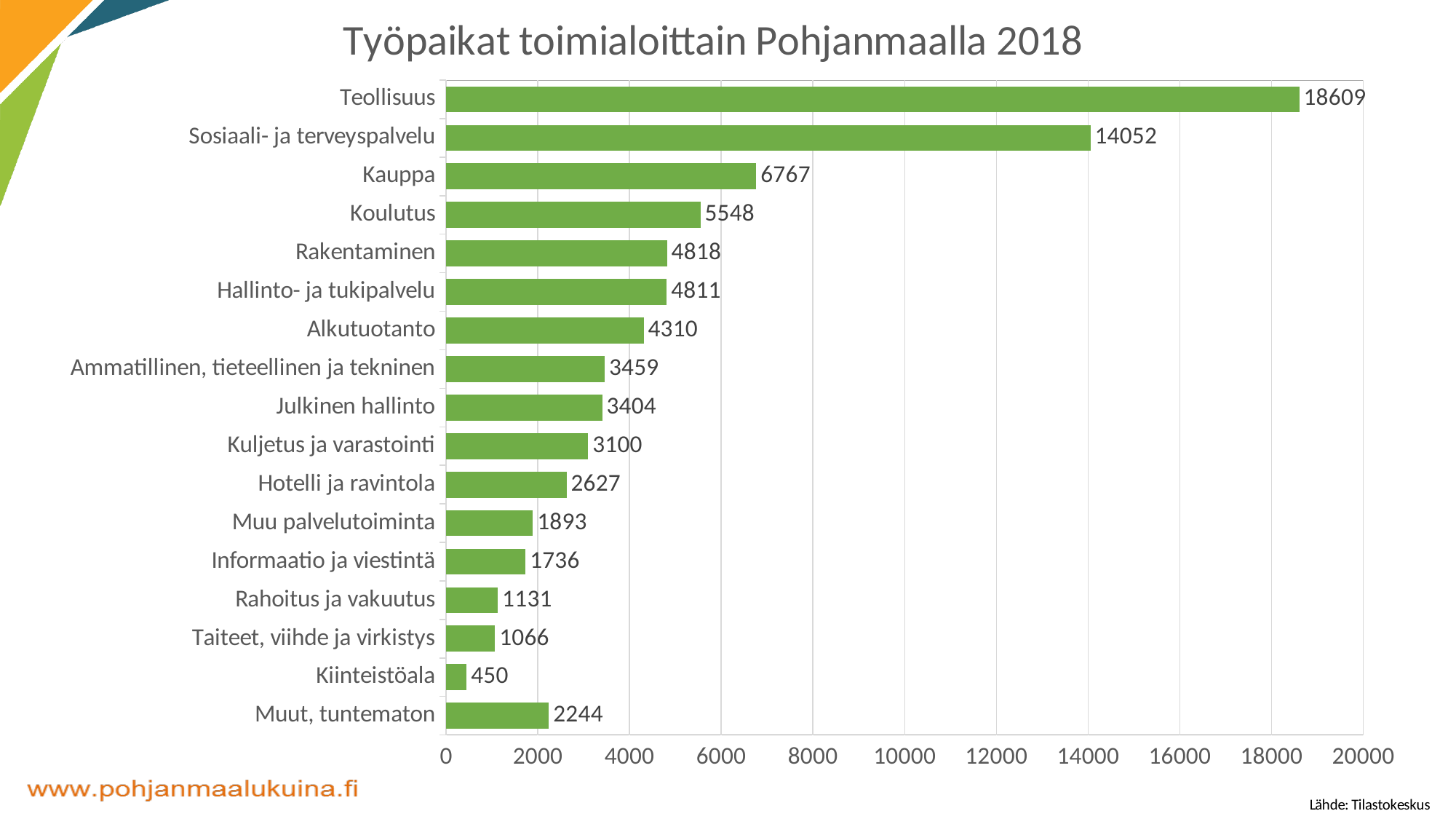
What is the difference between the values for Kauppa and Koulutus? 1219 What is the value for Muut, tuntematon? 2244 Is the value for Alkutuotanto greater or less than 4000? greater What is the title of the chart? Työpaikat toimialoittain Pohjanmaalla 2018 Which category has the lowest value? Kiinteistöala What is the value for Teollisuus? 18609 Which is larger, the value for Hotelli ja ravintola or the value for Muu palvelutoiminta? Hotelli ja ravintola What kind of chart is shown on the slide? bar chart What is the difference between the values for Teollisuus and Sosiaali- ja terveyspalvelu? 4557 What is the value for Kuljetus ja varastointi? 3100 Which category has the highest value? Teollisuus How many categories are shown in the chart? 17